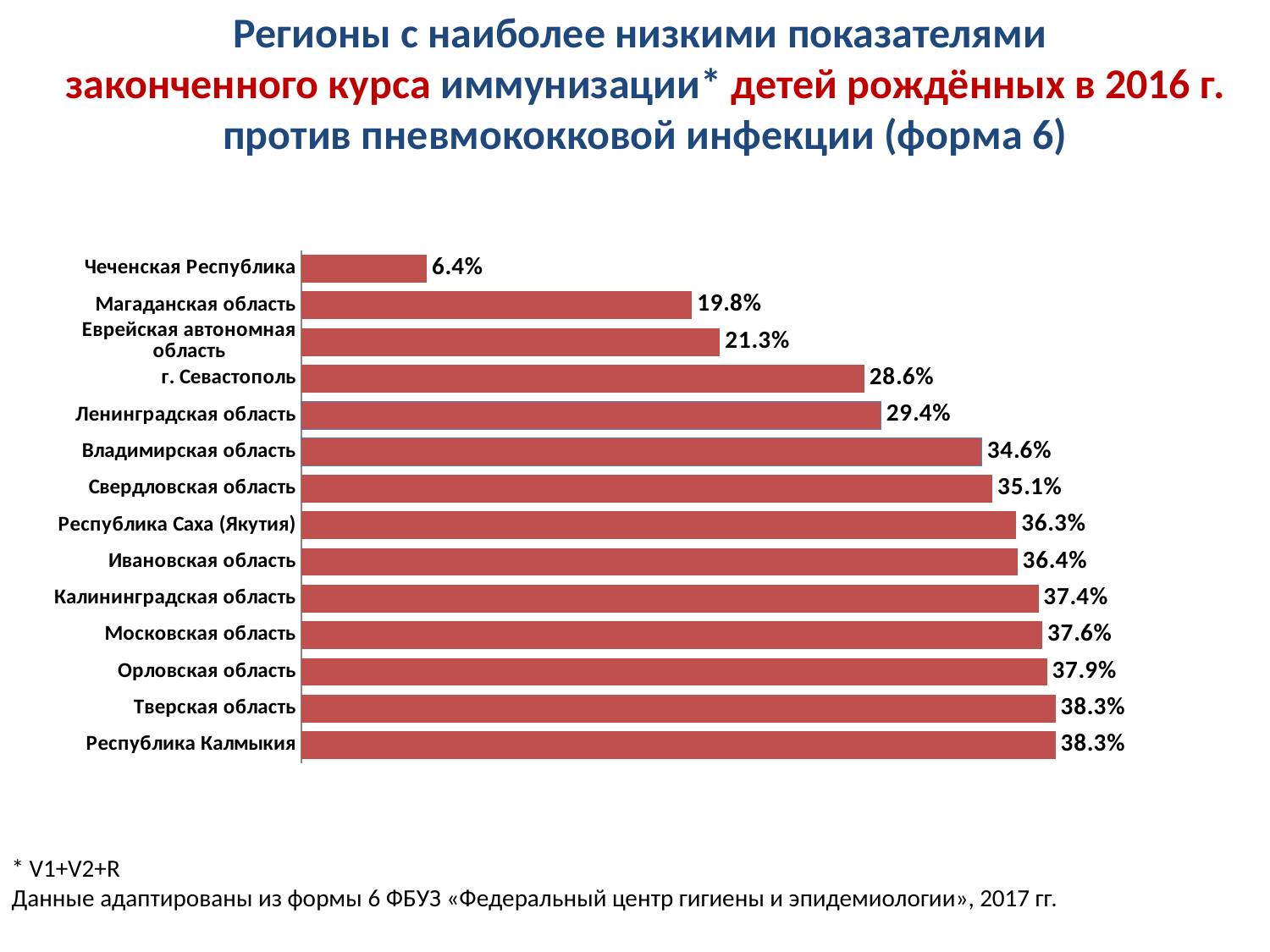
What is the difference between the values for Республика Калмыкия and г. Севастополь? 9.7 percentage points Which is larger, the value for Владимирская область or the value for Ленинградская область? Владимирская область How many regions are shown on the chart? 14 What is the value for Орловская область? 37.9% Which region has the lowest value on the chart? Чеченская Республика What is the value for Республика Саха (Якутия)? 36.3% What is the value for Чеченская Республика? 6.4% What is the difference between the values for Магаданская область and Чеченская Республика? 13.4 percentage points Do the values increase or decrease going from the top bar to the bottom bar? Increase What is the value for Ленинградская область? 29.4% What kind of chart is shown on the slide? Bar chart Which is larger, the value for Еврейская автономная область or the value for Свердловская область? Свердловская область